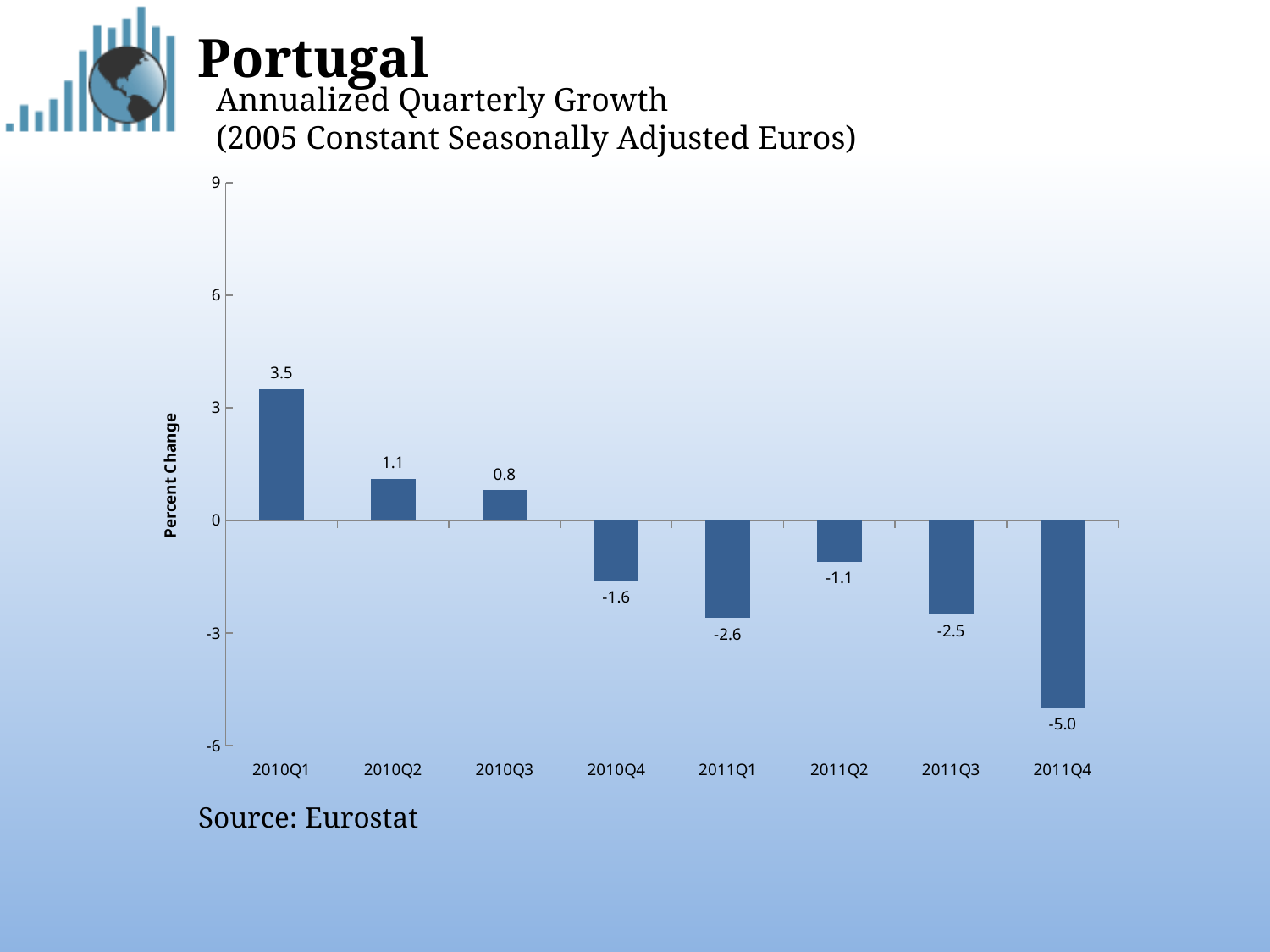
Is the value for 2010Q1 greater or less than 3? greater Which quarter has the lowest value? 2011Q4 What is the difference between the values for 2010Q1 and 2010Q2? 2.4 What is the label of the vertical axis? Percent Change What kind of chart is shown on the slide? bar chart Which quarter has the highest value? 2010Q1 What is the difference between the values for 2011Q3 and 2011Q4? 2.5 Which is larger, the value for 2010Q4 or the value for 2011Q2? 2011Q2 What is the annualized quarterly growth value for 2010Q1? 3.5 What is the value shown for 2011Q1? -2.6 What is the value shown for 2011Q4? -5.0 How many quarters are shown on the x axis? 8